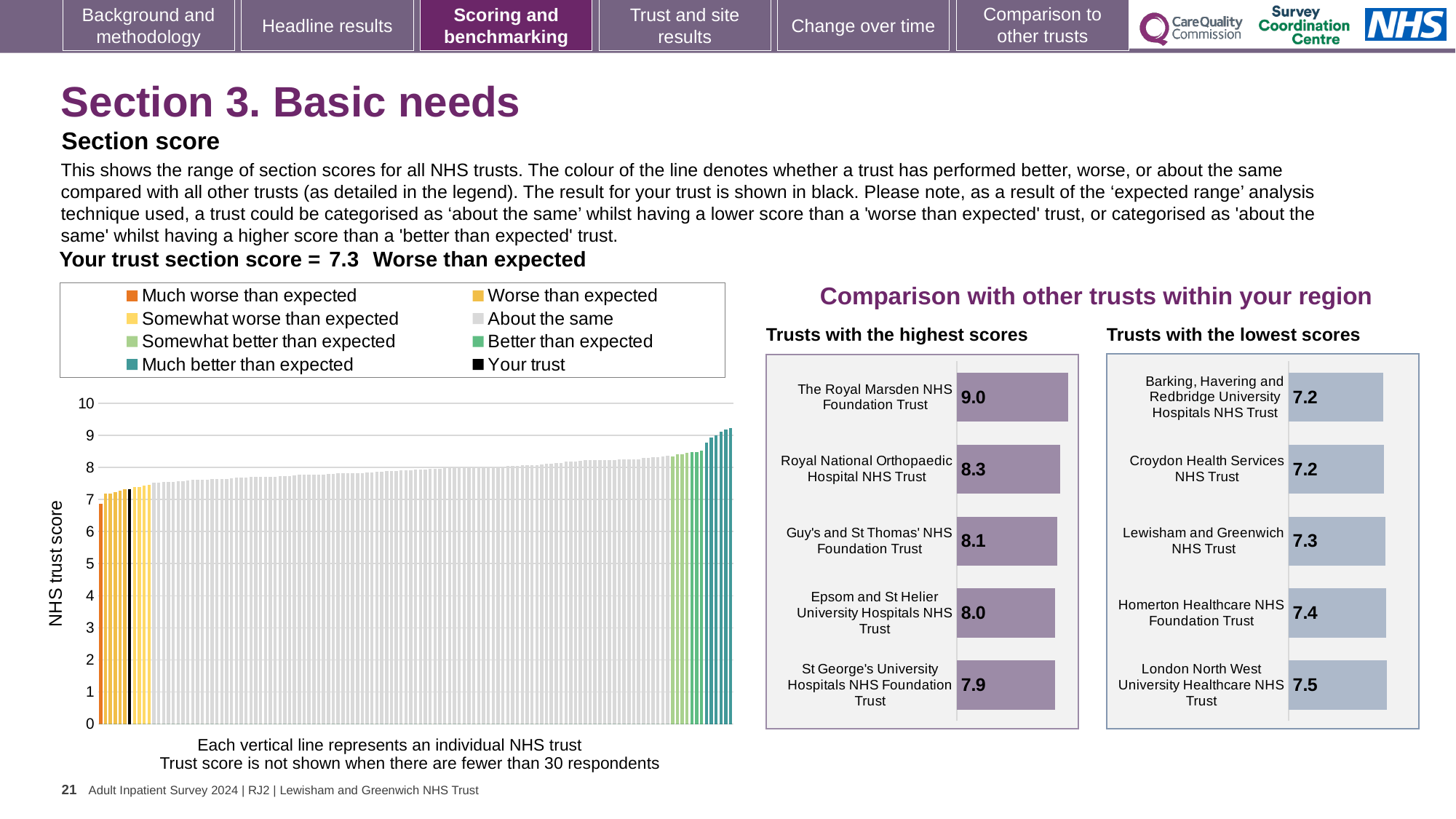
In the 'Trusts with the highest scores' chart, which trust has the lowest score? St George's University Hospitals NHS Foundation Trust How many trusts are shown in the 'Trusts with the highest scores' chart? 5 What kind of chart is the NHS trust score chart on the left of the slide? Bar chart In the 'Trusts with the lowest scores' chart, what is the score for Homerton Healthcare NHS Foundation Trust? 7.4 In the 'Trusts with the highest scores' chart, what is the score for Epsom and St Helier University Hospitals NHS Trust? 8.0 In the 'Trusts with the highest scores' chart, what is the score for The Royal Marsden NHS Foundation Trust? 9.0 In the NHS trust score chart on the left, do the values rise or fall from left to right along the x axis? Rise How many entries does the legend of the NHS trust score chart on the left list? 8 In the 'Trusts with the lowest scores' chart, which trust has the highest score? London North West University Healthcare NHS Trust In the 'Trusts with the lowest scores' chart, what is the difference between the scores of London North West University Healthcare NHS Trust and Croydon Health Services NHS Trust? 0.3 In the 'Trusts with the lowest scores' chart, which has the larger score: Lewisham and Greenwich NHS Trust or Homerton Healthcare NHS Foundation Trust? Homerton Healthcare NHS Foundation Trust In the 'Trusts with the highest scores' chart, what is the difference between the scores of The Royal Marsden NHS Foundation Trust and St George's University Hospitals NHS Foundation Trust? 1.1